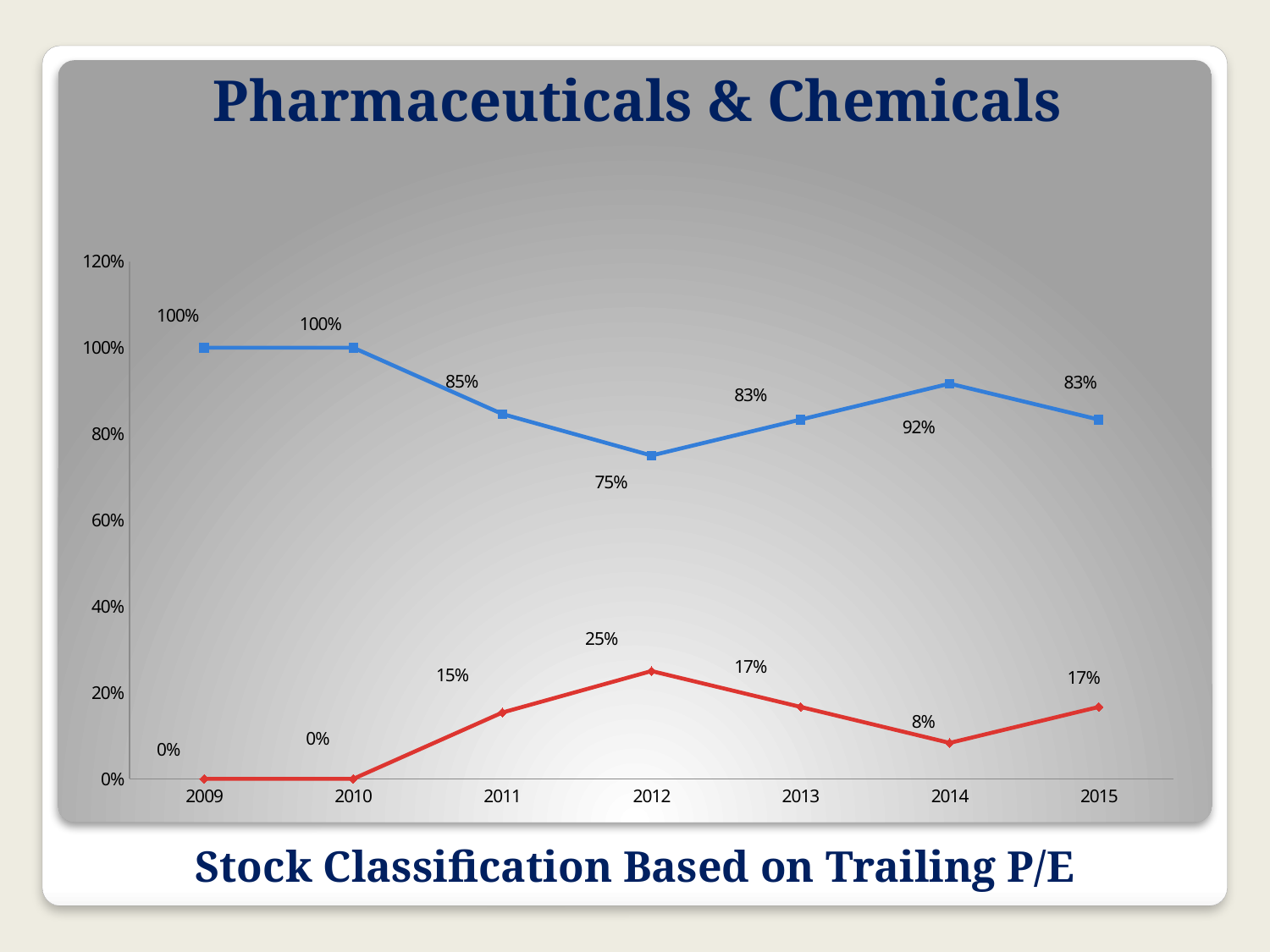
In which year does the red line reach its highest value? 2012 In which year does the blue line reach its lowest value? 2012 How many years are plotted along the x axis? 7 What type of chart is shown on the slide? line chart What is the difference between the blue line and the red line in 2015? 66% Which is larger in 2011, the blue line value or the red line value? blue line What is the value of the red line in 2014? 8% What is the value of the blue line in 2014? 92% What is the value of the red line in 2009? 0% What is the value of the blue line in 2012? 75% Does the red line rise or fall from 2010 to 2012? rise What is the title shown above the chart? Pharmaceuticals & Chemicals